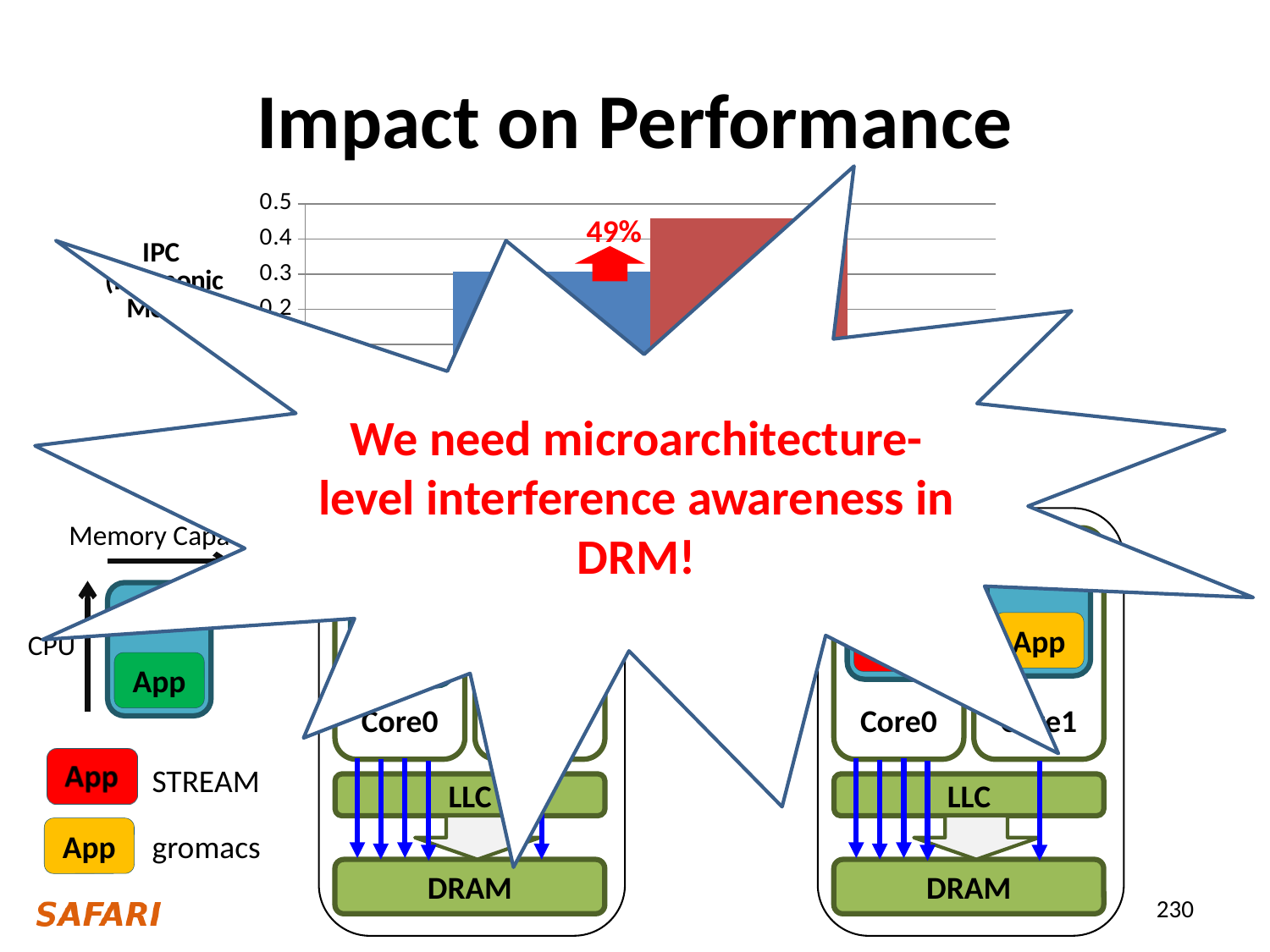
Is the value of the red bar in the chart greater or less than 0.4? greater What percentage improvement is annotated above the bars in the chart? 49% Which bar in the chart is taller, the blue bar or the red bar? the red bar What is the highest value shown on the chart's y axis? 0.5 What kind of chart is shown at the top of the slide? bar chart Is the value of the blue bar in the chart greater or less than 0.4? less